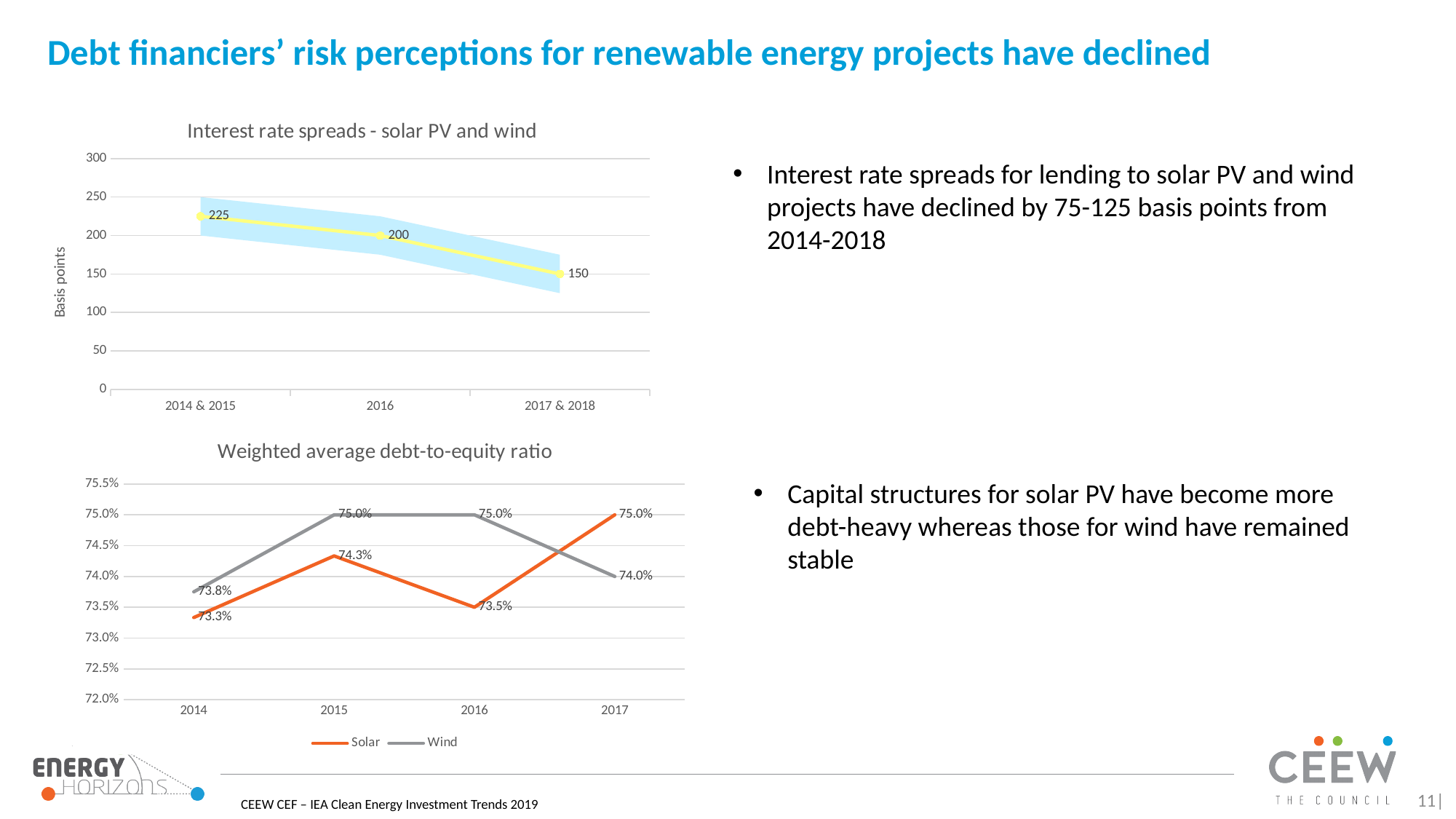
In the 'Interest rate spreads - solar PV and wind' chart, do the values rise or fall along the x axis? fall How many series does the legend of the 'Weighted average debt-to-equity ratio' chart list? 2 In the 'Weighted average debt-to-equity ratio' chart, what is the Wind value for 2017? 74.0% In the 'Weighted average debt-to-equity ratio' chart, what is the Solar value for 2015? 74.3% In the 'Interest rate spreads - solar PV and wind' chart, what is the value for 2016? 200 In the 'Interest rate spreads - solar PV and wind' chart, how many data points are plotted on the line? 3 In the 'Weighted average debt-to-equity ratio' chart, what is the difference between the Wind and Solar values in 2016? 1.5% In the 'Interest rate spreads - solar PV and wind' chart, what is the value for 2017 & 2018? 150 In the 'Interest rate spreads - solar PV and wind' chart, what is the difference between the 2014 & 2015 value and the 2017 & 2018 value? 75 In the 'Interest rate spreads - solar PV and wind' chart, what is the label on the vertical axis? Basis points In the 'Weighted average debt-to-equity ratio' chart, in which year is the Solar value lowest? 2014 In the 'Weighted average debt-to-equity ratio' chart, which series has the higher value in 2016, Solar or Wind? Wind